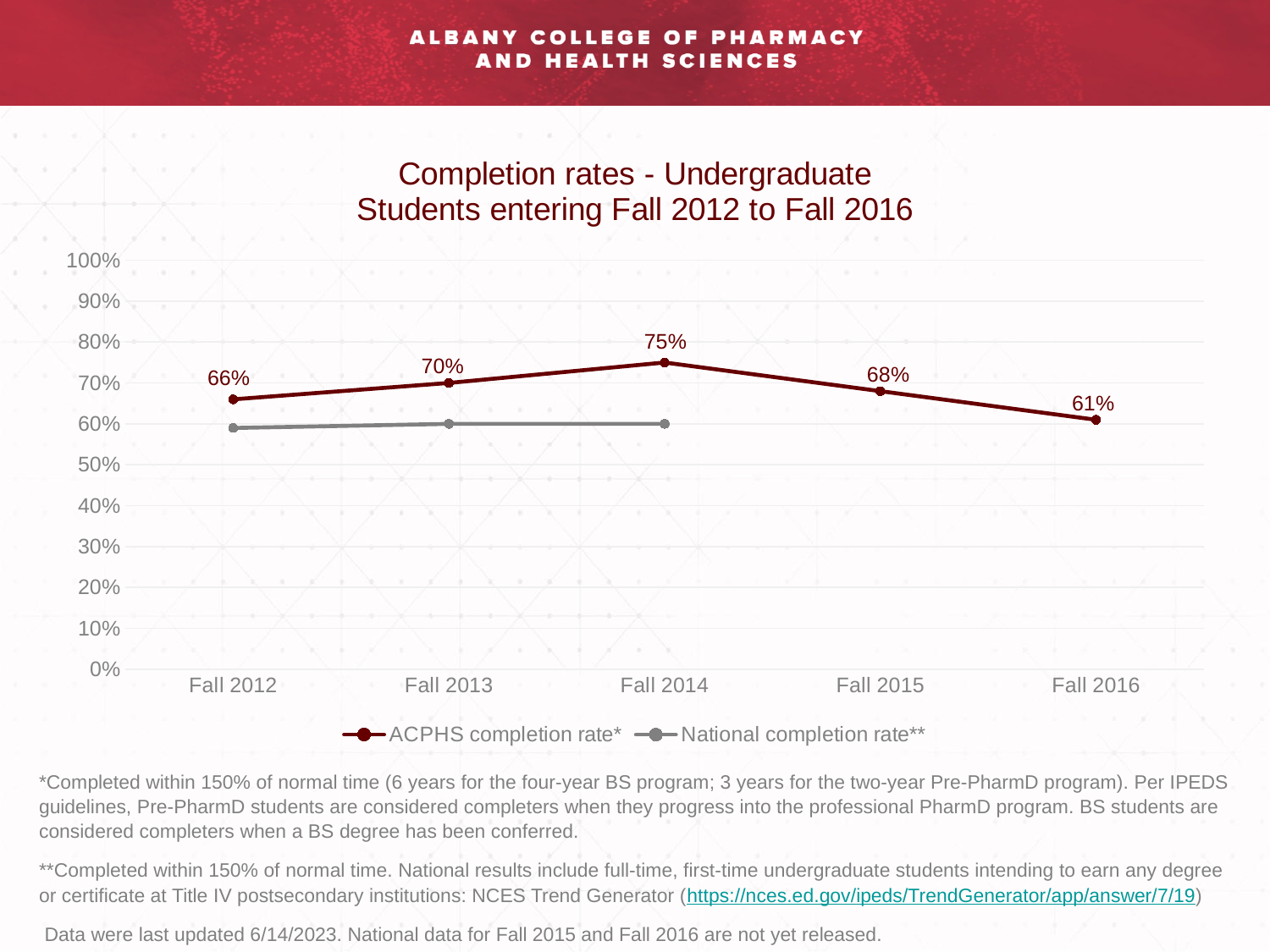
How many entering cohorts are shown on the x axis? 5 What kind of chart is shown on the slide? line chart What is the ACPHS completion rate for students entering Fall 2016? 61% Which entering cohort has the highest ACPHS completion rate? Fall 2014 What is the ACPHS completion rate for students entering Fall 2012? 66% Does the ACPHS completion rate rise or fall from Fall 2014 to Fall 2016? fall Which entering cohort has the lowest ACPHS completion rate? Fall 2016 How many series does the legend list? 2 What is the ACPHS completion rate for students entering Fall 2014? 75% Is the national completion rate for Fall 2013 greater or less than 70%? less What is the difference between the ACPHS completion rate for Fall 2014 and Fall 2016? 14% Which is larger, the ACPHS completion rate for Fall 2013 or for Fall 2015? Fall 2013